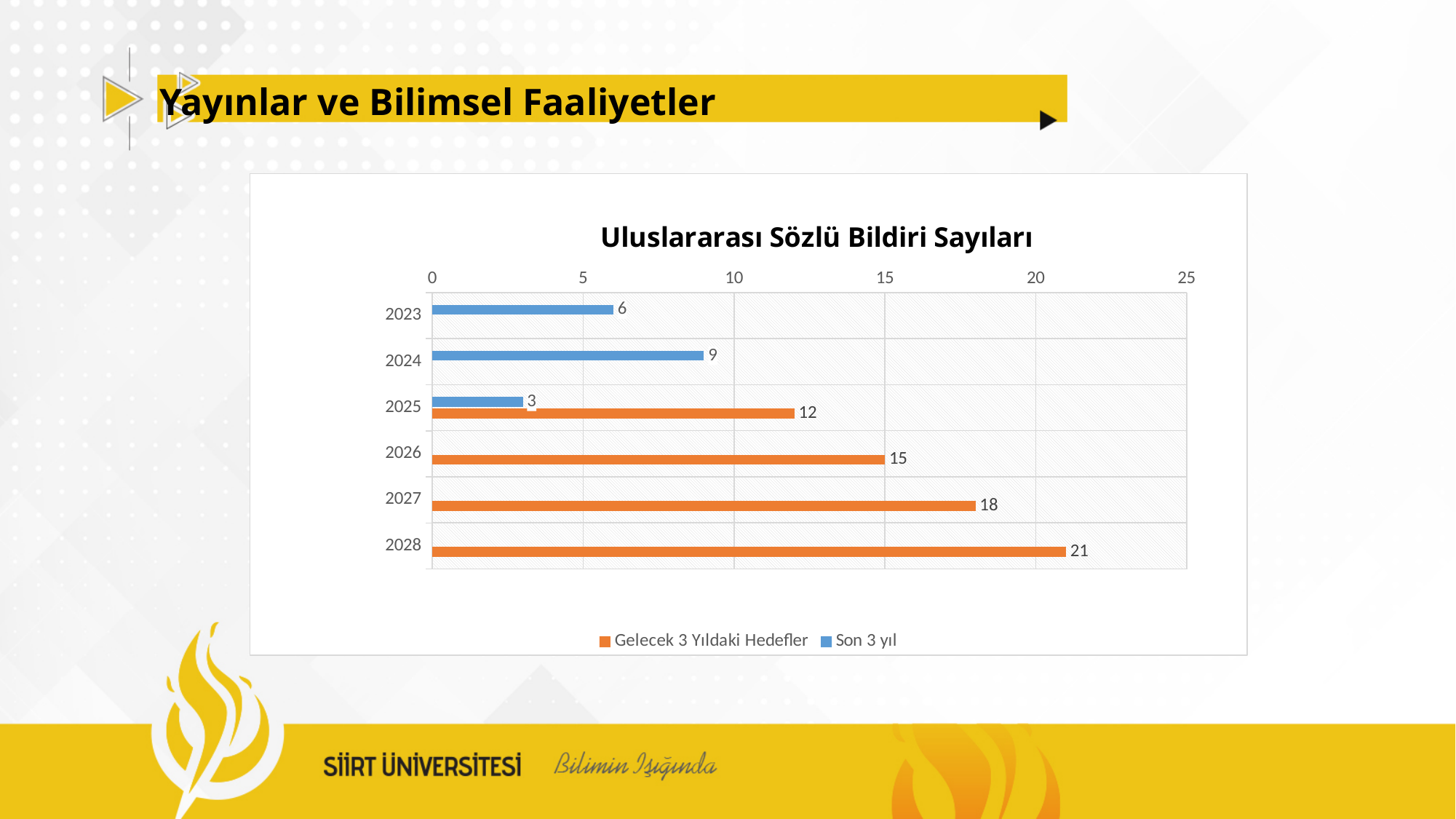
Which is larger: the 'Son 3 yıl' value for 2023 or for 2024? 2024 How many series does the legend list? 2 What is the title of the chart? Uluslararası Sözlü Bildiri Sayıları How many years are shown on the vertical axis of the chart? 6 What is the value of the 'Son 3 yıl' series for 2024? 9 What is the value of the 'Son 3 yıl' series for 2025? 3 Which year has the highest value in the 'Gelecek 3 Yıldaki Hedefler' series? 2028 What is the difference between the 'Gelecek 3 Yıldaki Hedefler' value for 2028 and for 2026? 6 Is the 'Gelecek 3 Yıldaki Hedefler' value for 2028 greater or less than 20? greater What is the value of the 'Gelecek 3 Yıldaki Hedefler' series for 2027? 18 What kind of chart is shown on the slide? bar chart Which year has the lowest value in the 'Son 3 yıl' series? 2025